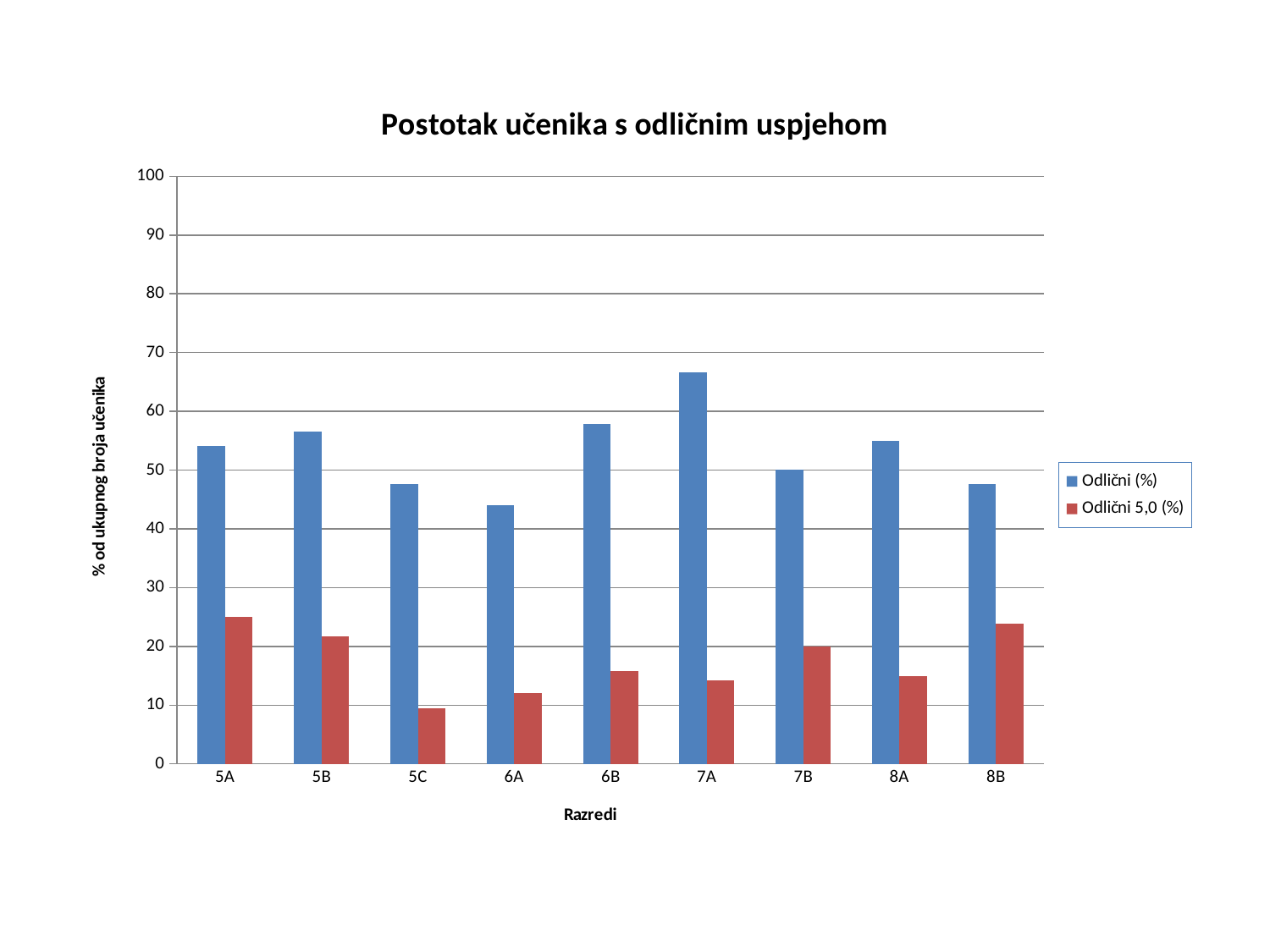
Is the Odlični (%) value for 6A greater or less than 50? less Which class has the highest value for Odlični (%)? 7A Which class has the lowest value for Odlični 5,0 (%)? 5C Which class has the lowest value for Odlični (%)? 6A Which class has the larger Odlični (%) value, 5B or 5C? 5B How many series does the legend list? 2 How many classes (categories) are shown on the x axis? 9 Is the Odlični (%) value for 7A greater or less than 60? greater What type of chart is shown on the slide? bar chart Which class has the larger Odlični 5,0 (%) value, 5A or 6A? 5A What is the title of the chart? Postotak učenika s odličnim uspjehom